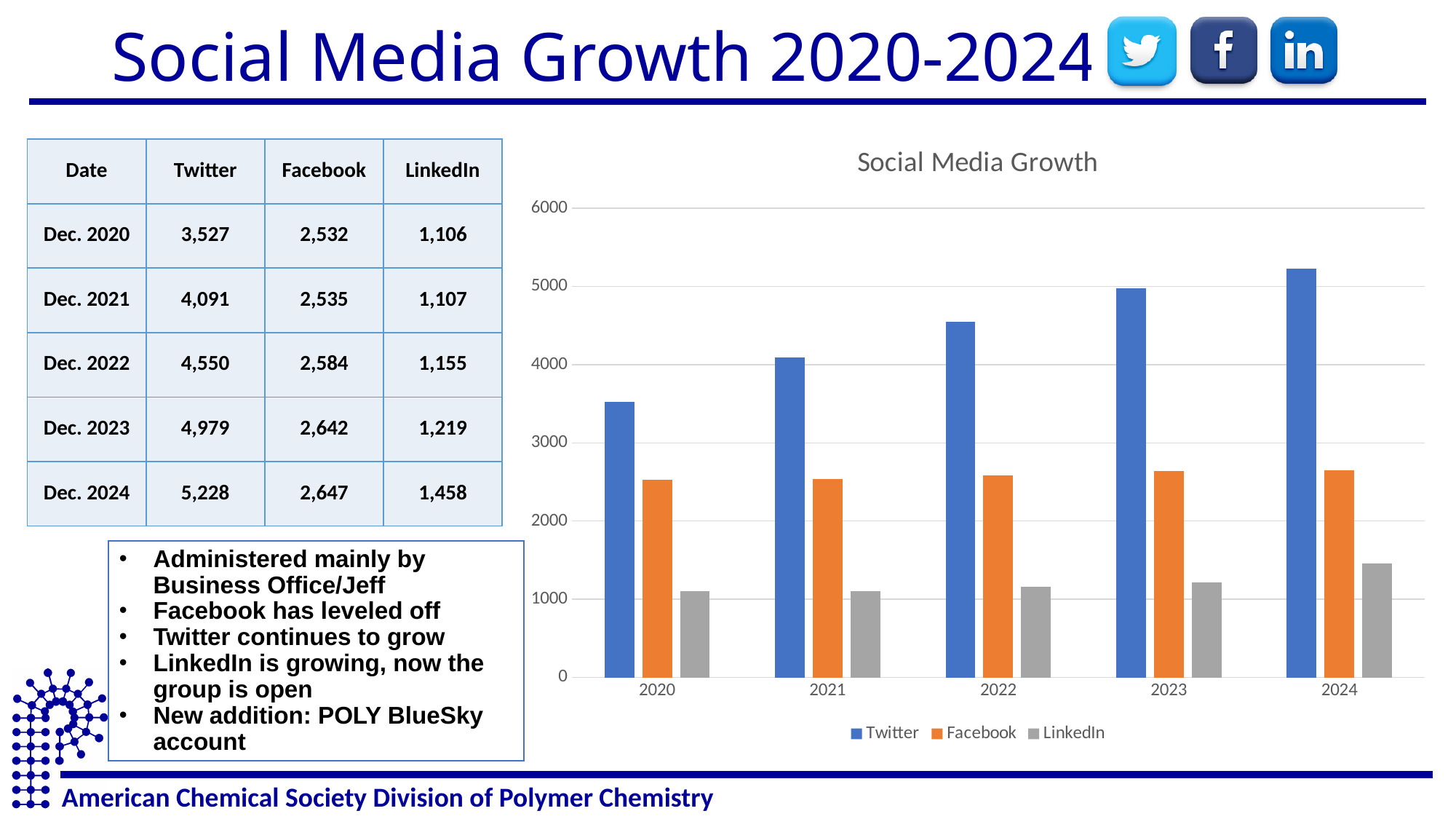
According to the table on the slide, what is the Twitter value for Dec. 2024? 5,228 Which is larger in 2022, the Facebook bar or the LinkedIn bar? Facebook Is the LinkedIn value for 2023 greater or less than 1000? greater What is the title of the chart? Social Media Growth What kind of chart is shown on the slide? bar chart How many series does the chart legend list? 3 Is the Facebook value for 2020 greater or less than 3000? less Which series has the lowest bar in 2024? LinkedIn Which series has the highest bar in every year of the chart? Twitter Is the Twitter value for 2024 greater or less than 5000? greater How many years are shown on the x axis of the chart? 5 Do the Twitter bars rise or fall from 2020 to 2024? rise